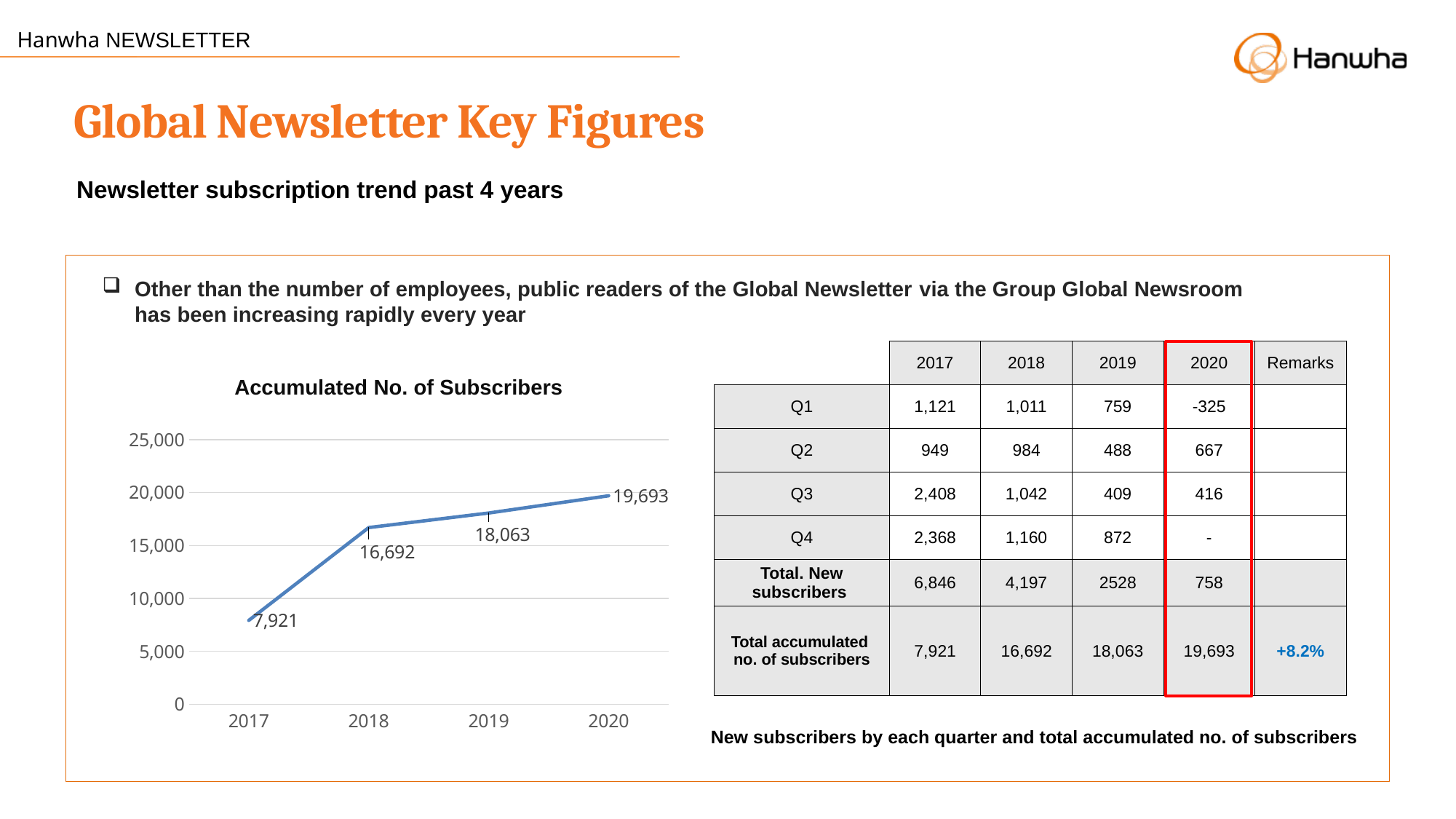
What is the accumulated number of subscribers in 2018 on the chart? 16,692 What is the difference in accumulated subscribers between 2018 and 2017 on the chart? 8,771 Which year has the lowest accumulated number of subscribers on the chart? 2017 What is the accumulated number of subscribers in 2019 on the chart? 18,063 How many years are plotted on the Accumulated No. of Subscribers chart? 4 What is the accumulated number of subscribers in 2017 on the chart? 7,921 What kind of chart is the Accumulated No. of Subscribers chart? line chart What is the difference in accumulated subscribers between 2020 and 2019 on the chart? 1,630 Do the accumulated subscriber values rise or fall from 2017 to 2020 on the chart? rise What is the accumulated number of subscribers in 2020 on the chart? 19,693 Is the accumulated number of subscribers in 2017 greater or less than 10,000? less Which year has the highest accumulated number of subscribers on the chart? 2020